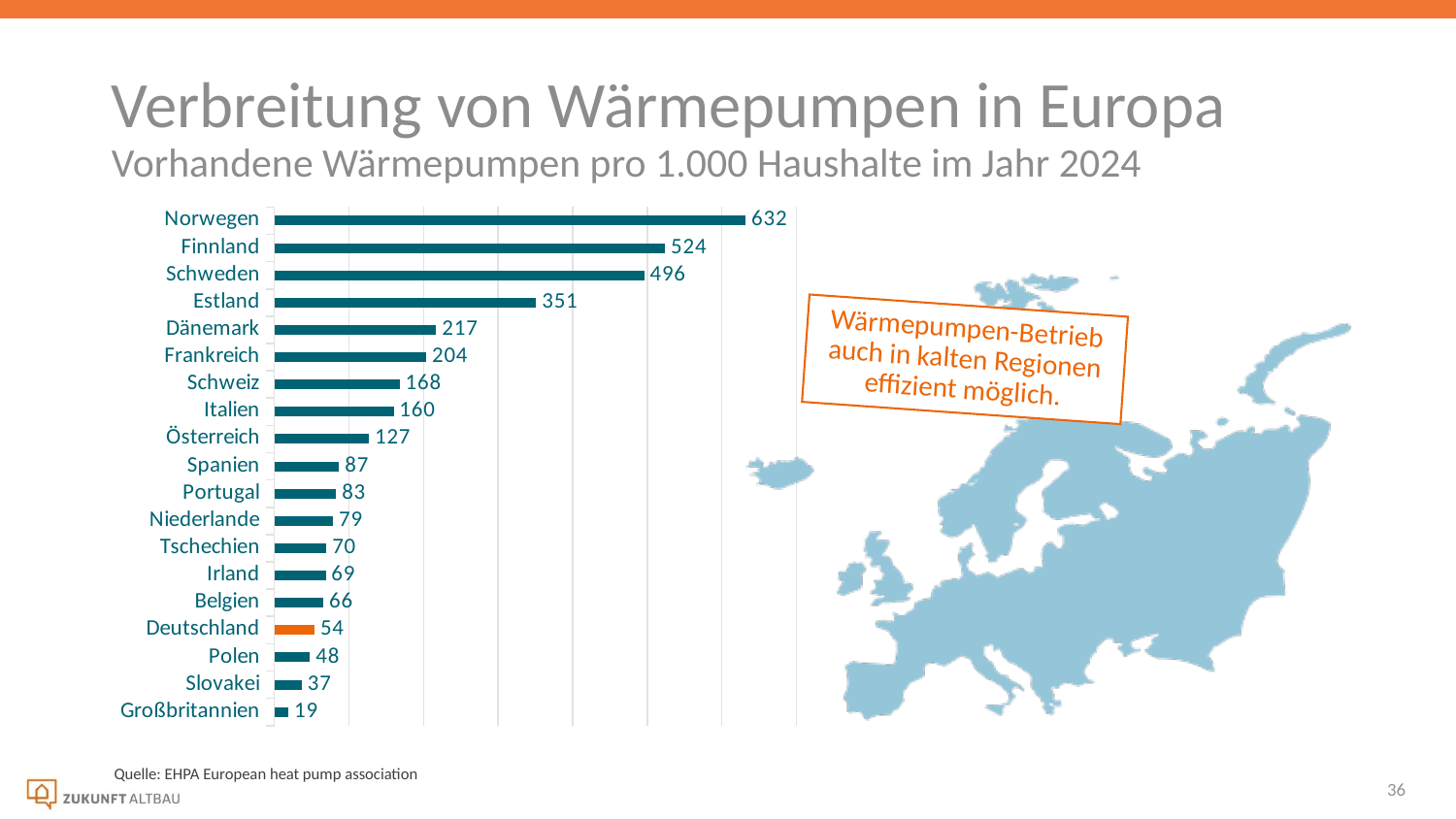
What is the value for Estland? 351 Which country's bar is highlighted in orange? Deutschland Which country has the lowest value? Großbritannien What is the value for Deutschland? 54 Which country has the highest value? Norwegen Which has a larger value, Dänemark or Frankreich? Dänemark What is the value for Niederlande? 79 What is the difference between the values for Norwegen and Finnland? 108 What kind of chart is shown on the slide? Bar chart How many countries are shown in the chart? 19 Which has a larger value, Schweiz or Italien? Schweiz What is the difference between the values for Deutschland and Polen? 6